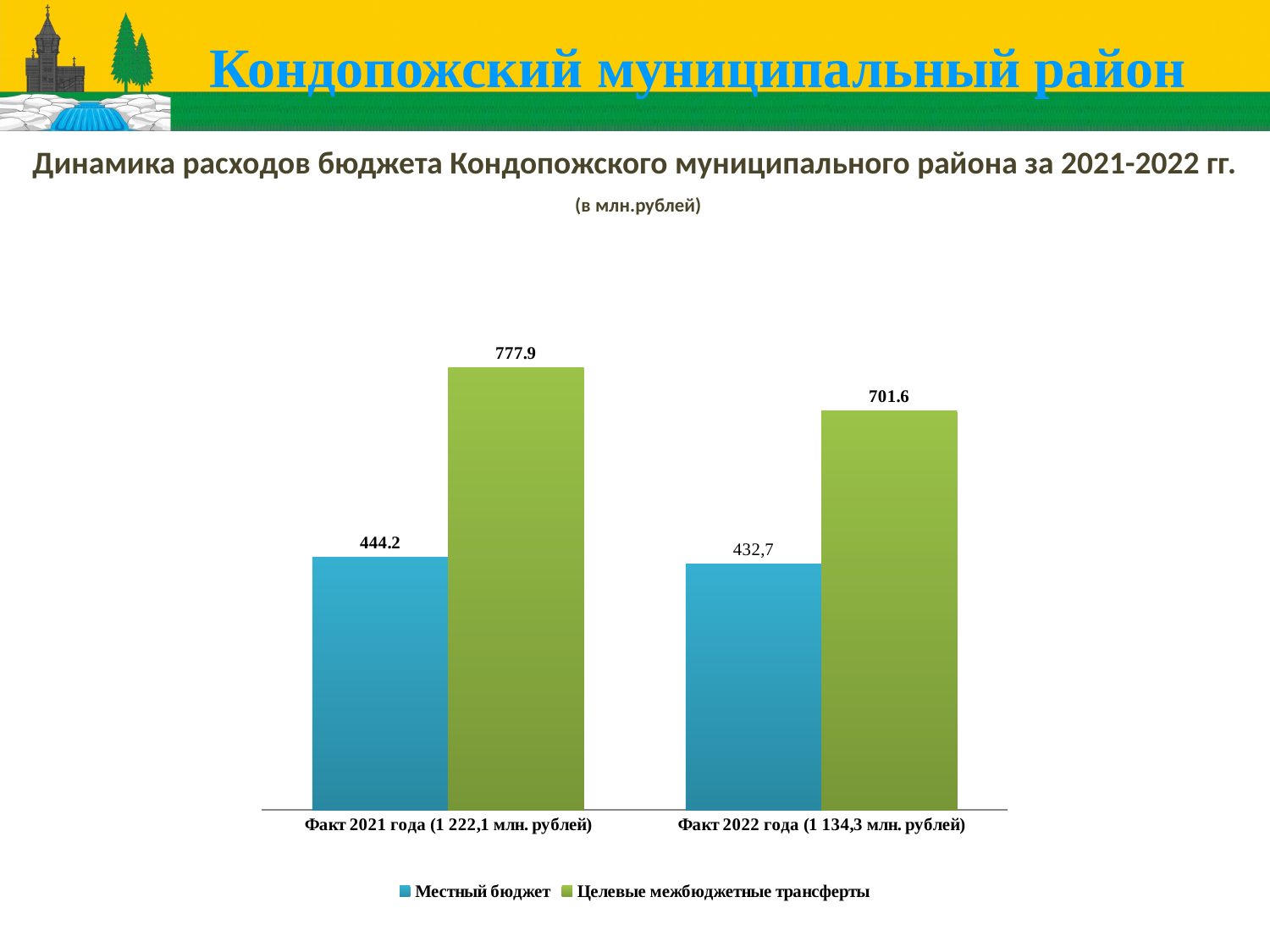
What is the value of Целевые межбюджетные трансферты for Факт 2021 года? 777.9 By how much did Целевые межбюджетные трансферты decrease from Факт 2021 года to Факт 2022 года? 76.3 What is the difference between Целевые межбюджетные трансферты and Местный бюджет for Факт 2021 года? 333.7 What kind of chart is shown on the slide? Bar chart Which bar has the highest value on the chart? Целевые межбюджетные трансферты, Факт 2021 года Which bar has the lowest value on the chart? Местный бюджет, Факт 2022 года Do the values of Местный бюджет rise or fall from Факт 2021 года to Факт 2022 года? Fall What is the value of Целевые межбюджетные трансферты for Факт 2022 года? 701.6 What is the value of Местный бюджет for Факт 2022 года? 432,7 Which is larger for Факт 2022 года: Местный бюджет or Целевые межбюджетные трансферты? Целевые межбюджетные трансферты What is the value of Местный бюджет for Факт 2021 года? 444.2 How many series does the legend list? 2